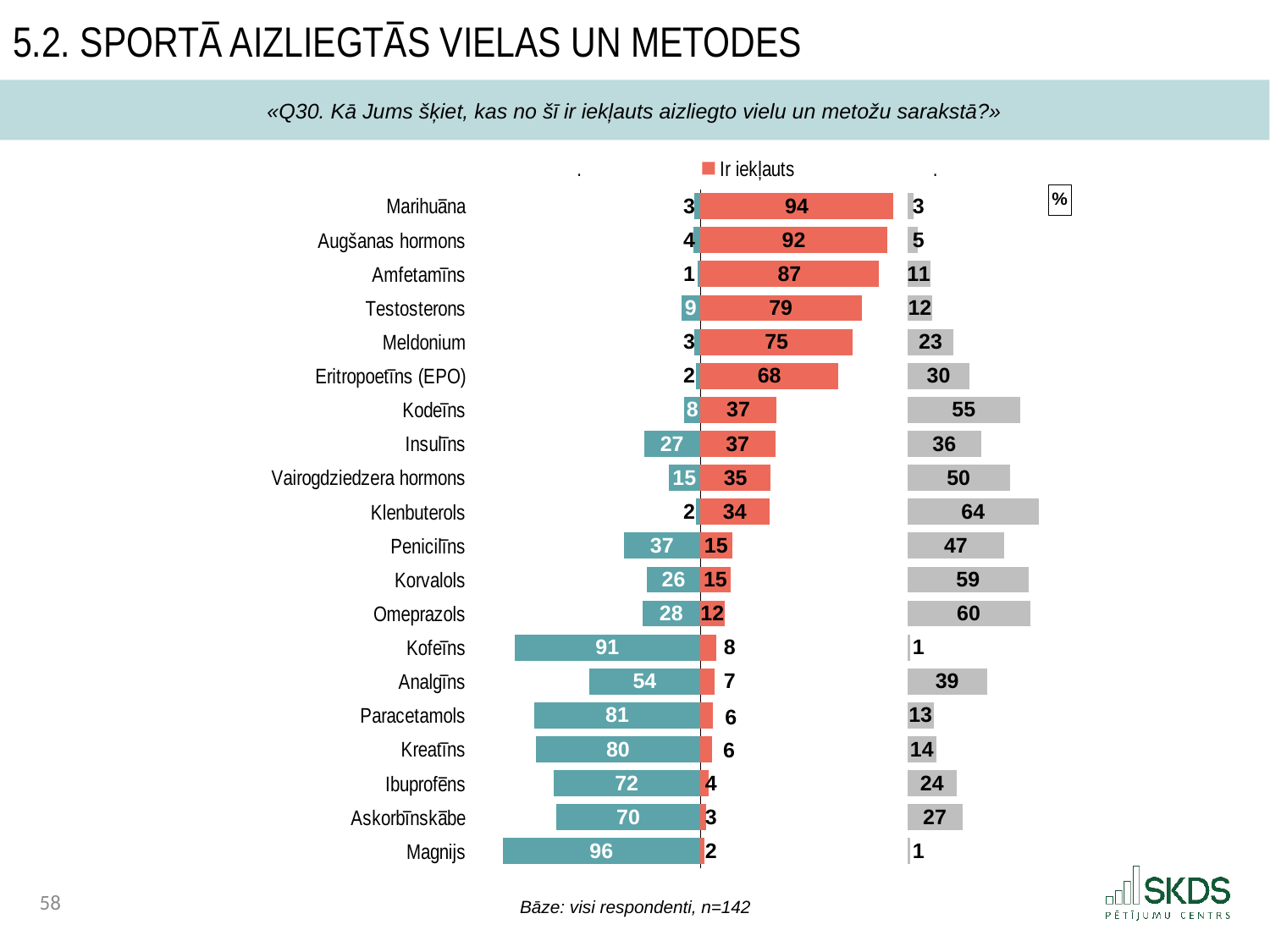
What is the value of the teal (left) bar for Magnijs? 96 What is the "Ir iekļauts" value for Marihuāna? 94 Which category has the highest value in the teal (left) series? Magnijs Which has a larger "Ir iekļauts" value, Meldonium or Kodeīns? Meldonium Which category has the highest "Ir iekļauts" value? Marihuāna Which category has the lowest "Ir iekļauts" value? Magnijs How many categories are shown in the chart? 20 What is the "Ir iekļauts" value for Eritropoetīns (EPO)? 68 What is the difference between the "Ir iekļauts" values for Amfetamīns and Testosterons? 8 What is the total of the three values shown for Insulīns? 100 What is the value of the grey (right) bar for Klenbuterols? 64 What type of chart is shown on the slide? Bar chart